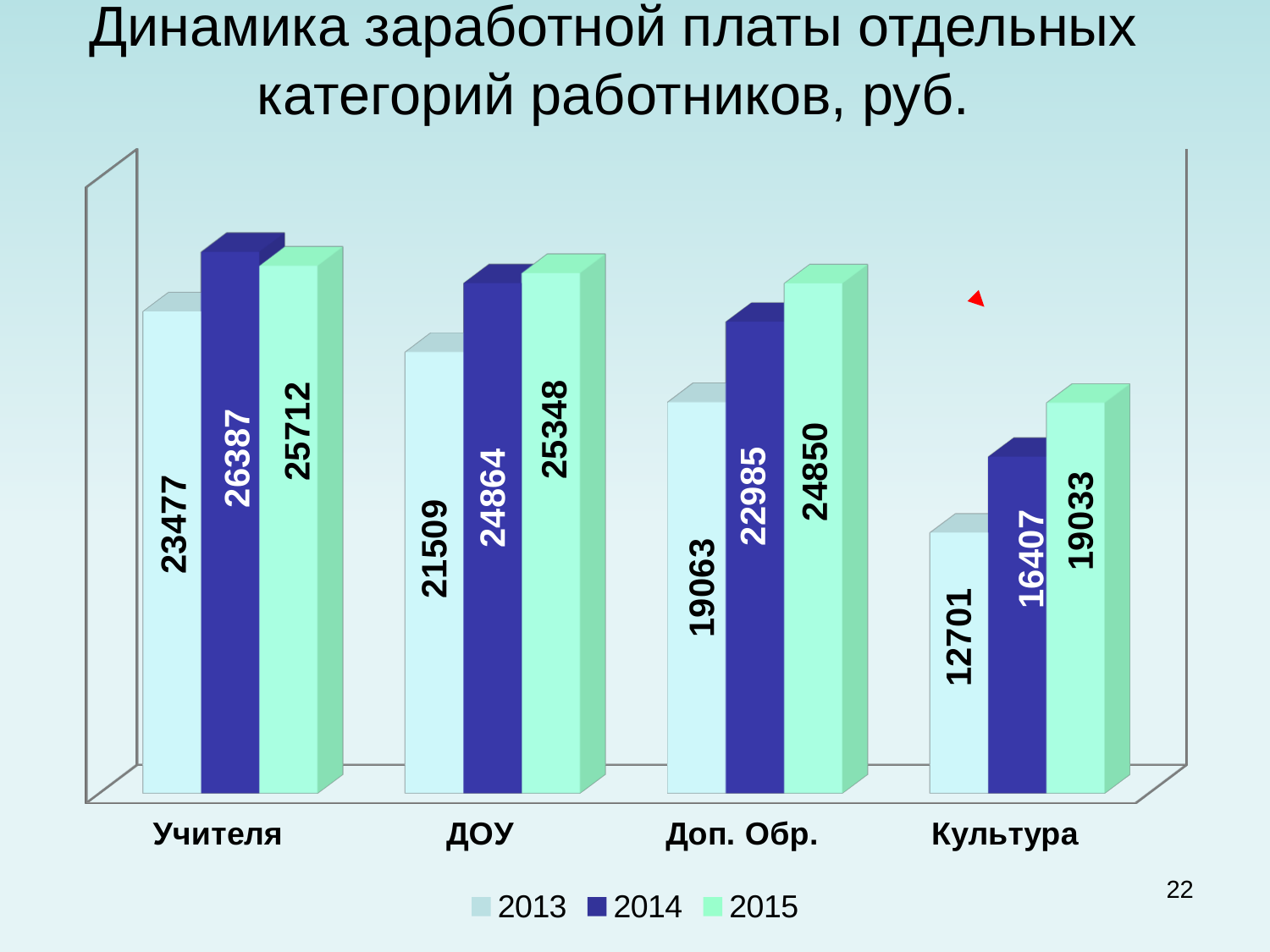
Which category has the highest 2015 value? Учителя For Учителя, which is larger: the 2014 value or the 2015 value? 2014 Which category has the lowest 2013 value? Культура How many series does the legend list? 3 What kind of chart is shown on the slide? bar chart What is the difference between the 2015 and 2013 values for Культура? 6332 What is the 2014 value for Учителя? 26387 What is the 2013 value for Культура? 12701 What is the 2015 value for Доп. Обр.? 24850 Do the 2013 values rise or fall from Учителя to Культура along the x axis? fall How many categories are shown on the x axis? 4 What is the 2015 value for ДОУ? 25348